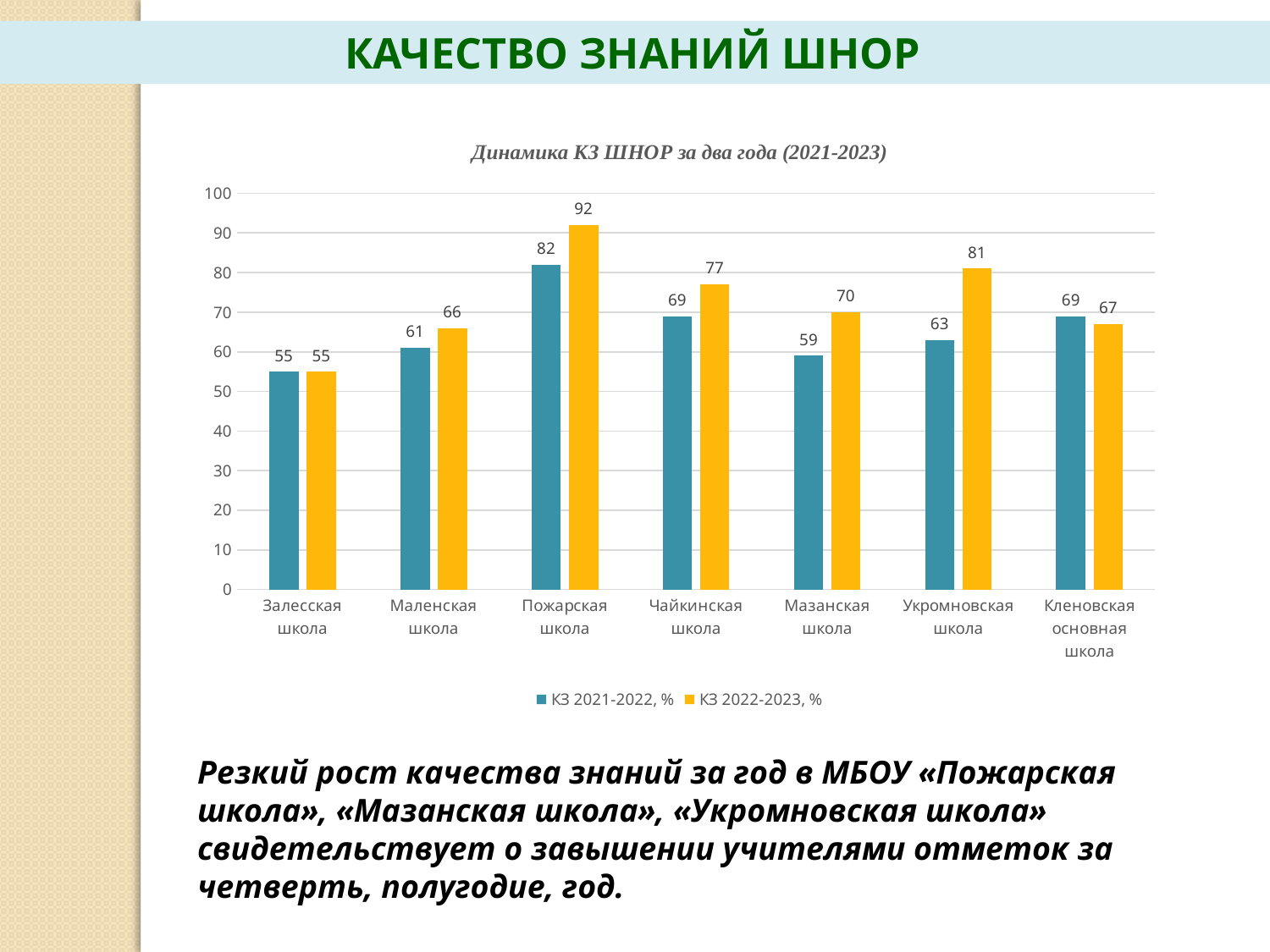
Which school has the lowest value in the КЗ 2021-2022, % series? Залесская школа How many schools are shown on the x axis of the chart? 7 What is the value for Мазанская школа in the КЗ 2021-2022, % series? 59 How many series does the chart legend list? 2 What is the difference between the КЗ 2022-2023, % and КЗ 2021-2022, % values for Укромновская школа? 18 What kind of chart is shown on the slide? Bar chart What is the title of the chart? Динамика КЗ ШНОР за два года (2021-2023) What is the value for Пожарская школа in the КЗ 2022-2023, % series? 92 What colour are the bars for the КЗ 2022-2023, % series? Yellow Which is larger for Кленовская основная школа: the КЗ 2021-2022, % value or the КЗ 2022-2023, % value? КЗ 2021-2022, % Which school has the highest value in the КЗ 2022-2023, % series? Пожарская школа What is the value for Укромновская школа in the КЗ 2022-2023, % series? 81